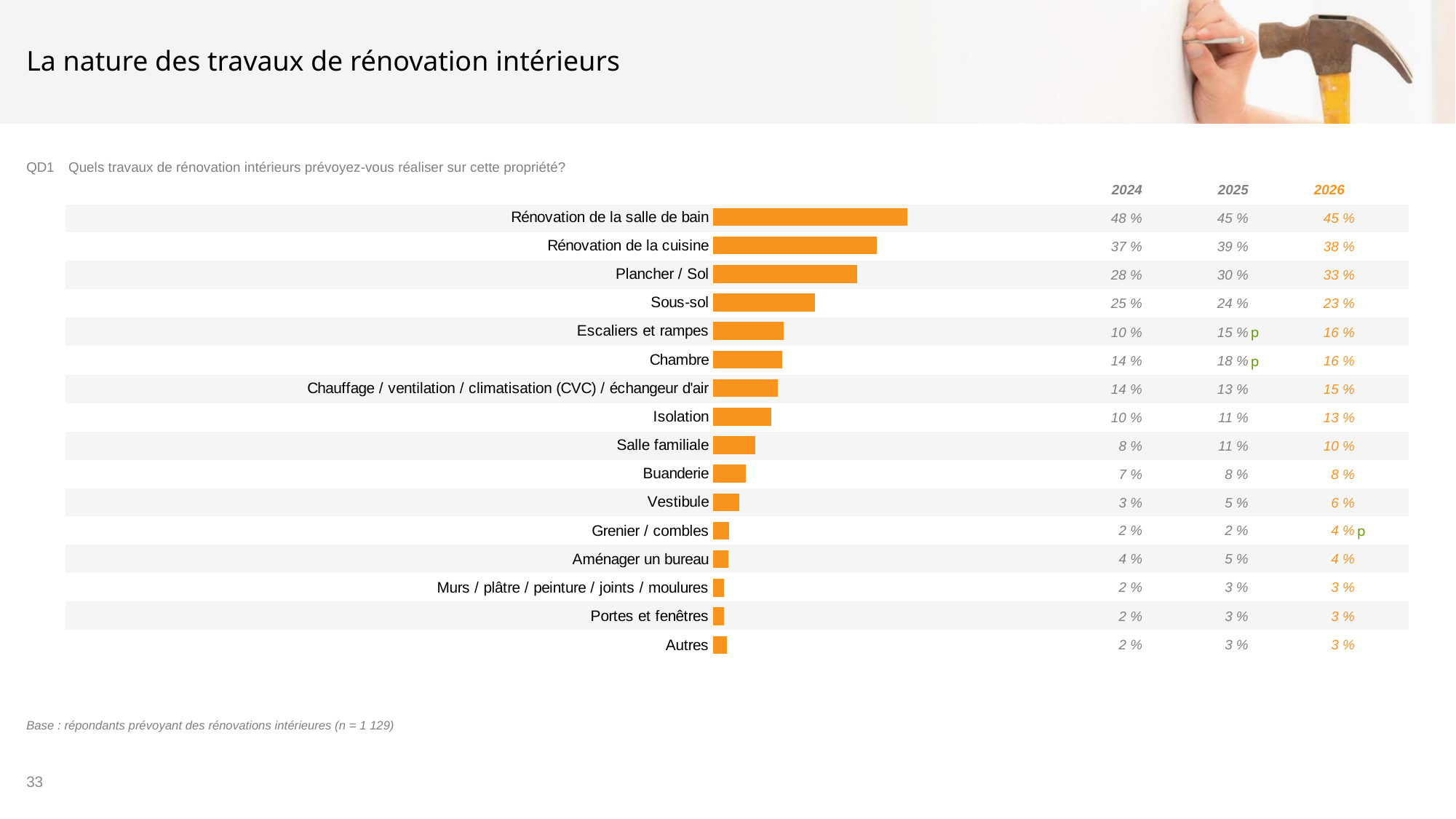
What is the difference between the 2024 and 2026 values for Escaliers et rampes? 6 % What is the 2024 value for Sous-sol? 25 % How many categories of interior renovation work are plotted in the chart? 16 What is the 2026 value for Plancher / Sol? 33 % Which has a longer bar, Sous-sol or Escaliers et rampes? Sous-sol What kind of chart is shown on the slide? bar chart Which category has the longest bar in the chart? Rénovation de la salle de bain What is the 2025 value for Chambre? 18 % What is the difference between the 2026 values for Rénovation de la salle de bain and Rénovation de la cuisine? 7 % Which year's values are shown in orange in the table? 2026 What is the 2026 value for Vestibule? 6 % What is the 2026 value for Rénovation de la salle de bain? 45 %